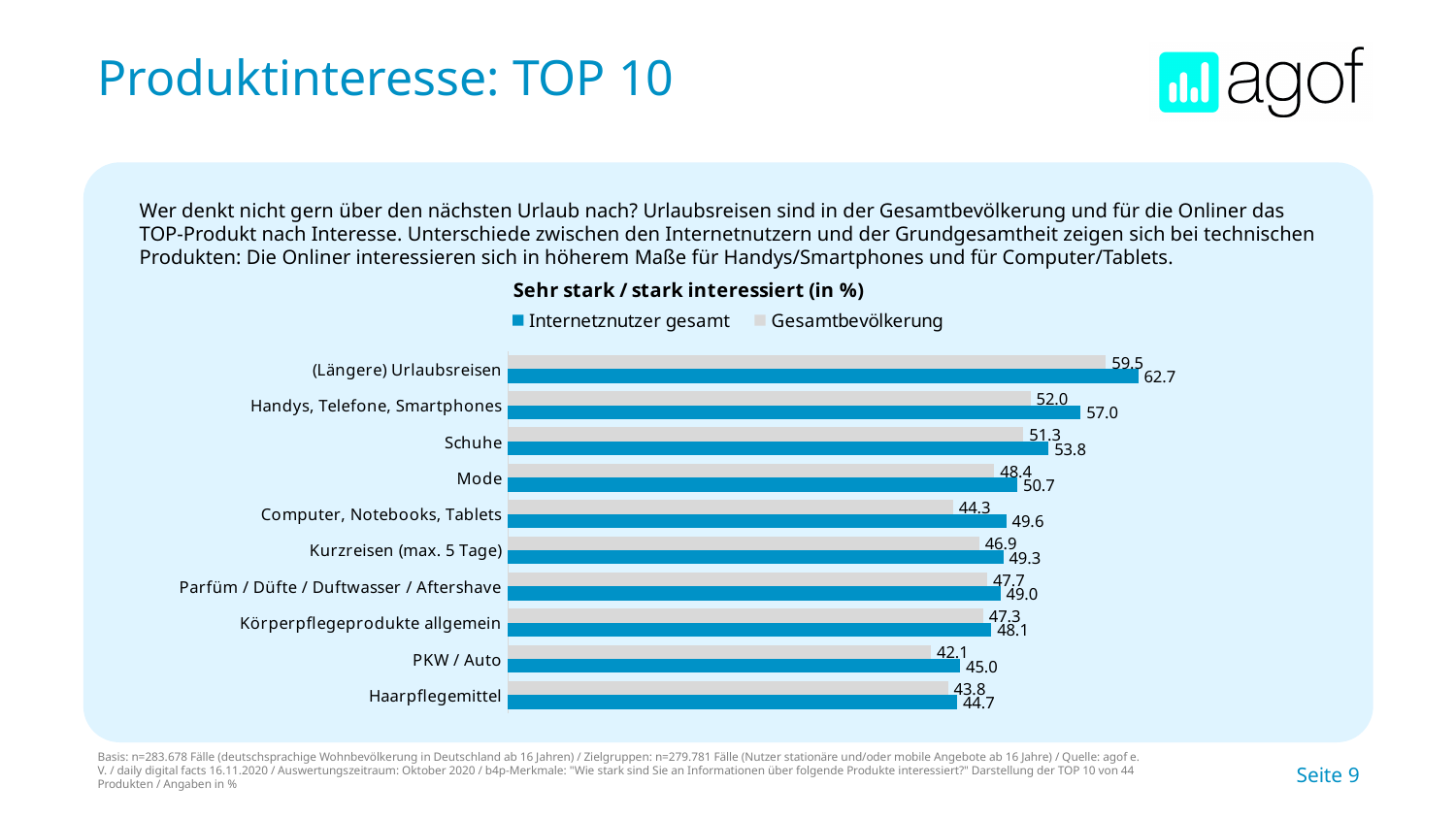
What is the difference between Internetnutzer gesamt and Gesamtbevölkerung for Handys, Telefone, Smartphones? 5.0 What is the title of the chart? Sehr stark / stark interessiert (in %) What kind of chart is shown on the slide? Bar chart Which category has the highest value for Internetnutzer gesamt? (Längere) Urlaubsreisen Which is larger for Computer, Notebooks, Tablets: the value for Internetnutzer gesamt or for Gesamtbevölkerung? Internetnutzer gesamt How many product categories are shown in the chart? 10 What is the value for Gesamtbevölkerung for Handys, Telefone, Smartphones? 52.0 How many series does the legend list? 2 What is the value for Internetnutzer gesamt for Computer, Notebooks, Tablets? 49.6 What is the value for Internetnutzer gesamt for (Längere) Urlaubsreisen? 62.7 What is the difference between the Internetnutzer gesamt values for (Längere) Urlaubsreisen and Haarpflegemittel? 18.0 Which category has the lowest value for Gesamtbevölkerung? PKW / Auto